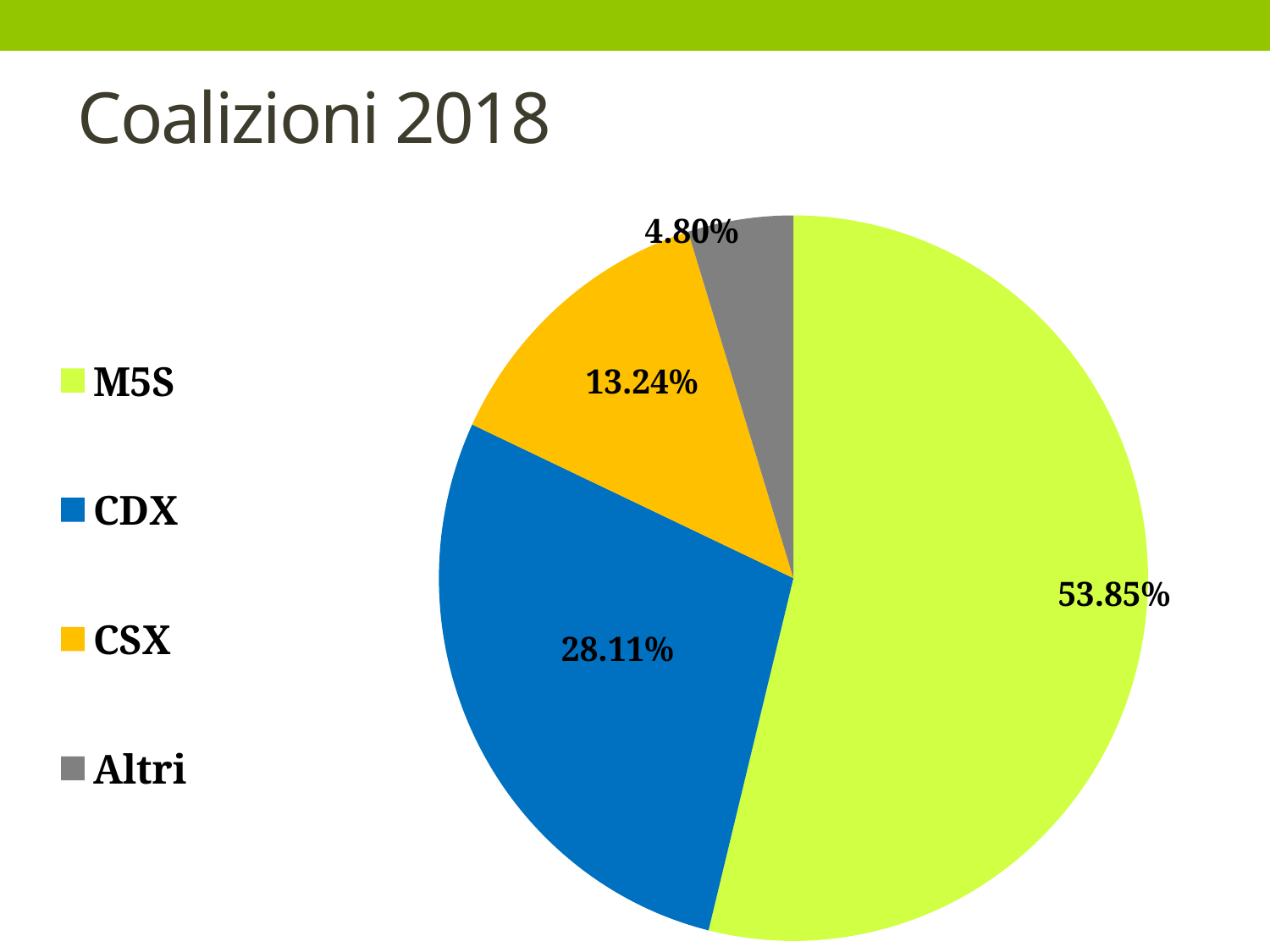
Which category has the largest share of the pie? M5S What is the title of the slide? Coalizioni 2018 Which is larger, the value for CDX or the value for CSX? CDX Which category has the smallest share of the pie? Altri What is the value for CDX? 28.11% How many slices does the pie chart have? 4 What is the value for Altri? 4.80% What is the difference between the values for M5S and CDX? 25.74% What is the value for CSX? 13.24% What type of chart is shown on the slide? pie chart What is the value for M5S? 53.85% Which colour represents CSX in the legend? orange